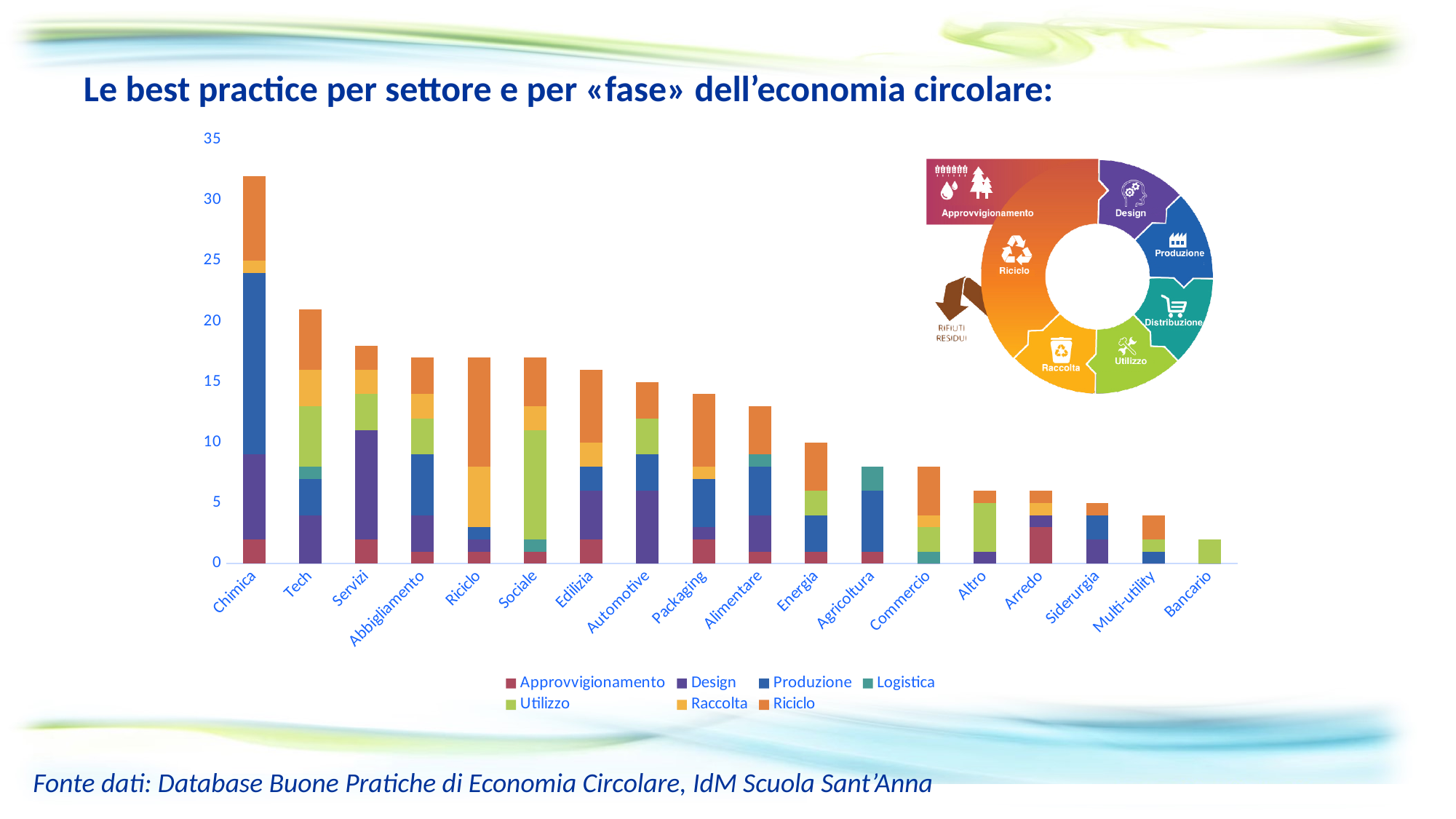
Which sector has a larger total, Tech or Servizi? Tech How many series does the chart legend list? 7 How many sectors (categories) are shown on the x axis of the chart? 18 Which series in the legend is shown in orange at the top of most bars? Riciclo Is the total value for Chimica greater or less than 30? greater Is the total value for Servizi greater or less than 15? greater Do the total bar heights generally rise or fall from left to right along the x axis? Fall What kind of chart is shown on the slide? Stacked bar chart Which sector has the tallest stacked bar? Chimica Which sector has the shortest stacked bar? Bancario Is the total value for Agricoltura greater or less than 10? less